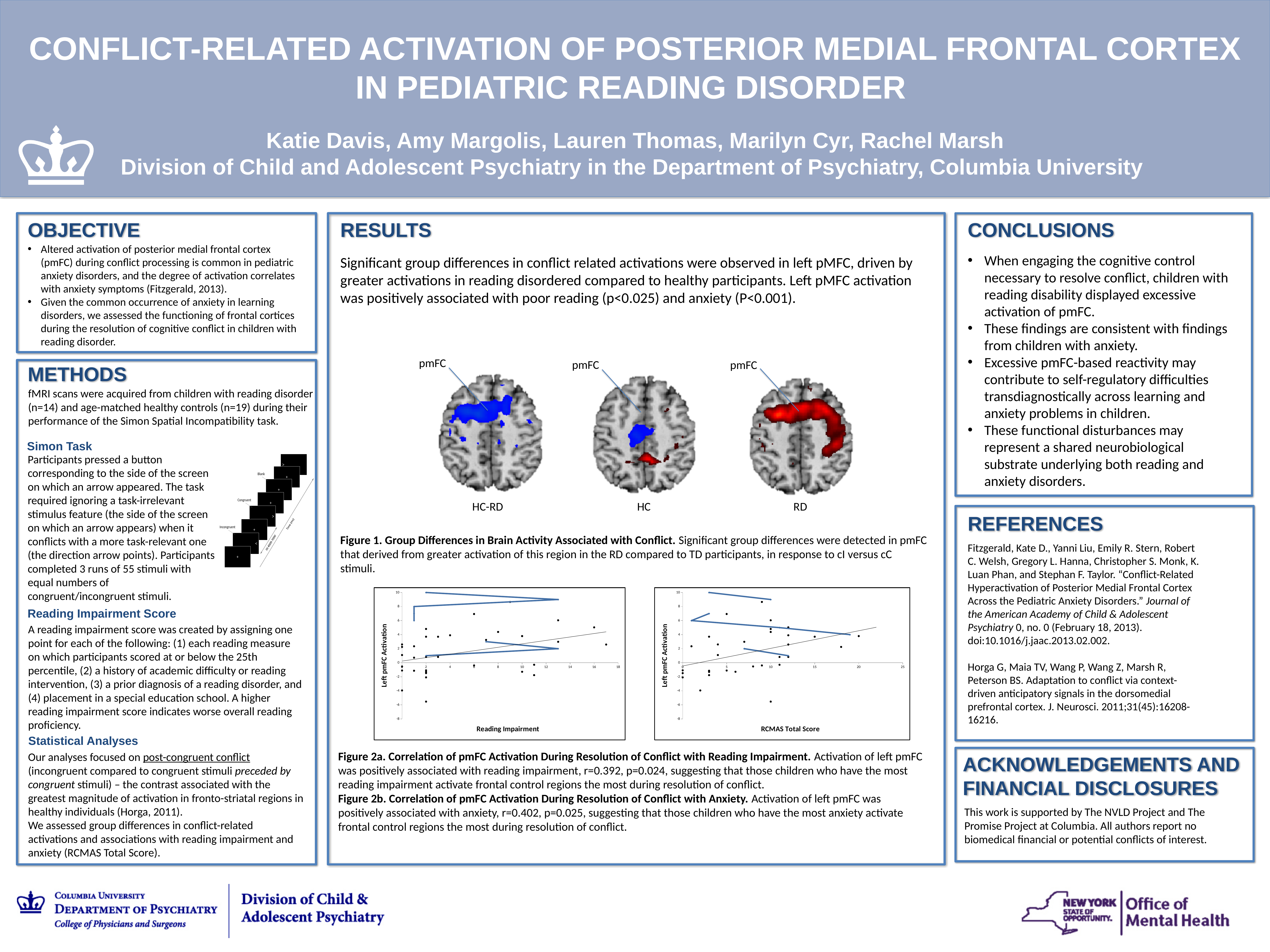
In the left scatter chart (Figure 2a), what is the highest tick value shown on the x axis? 18 What is the y-axis title shared by both scatter charts in Figures 2a and 2b? Left pmFC Activation What is the x-axis title of the left scatter chart (Figure 2a)? Reading Impairment In the right scatter chart (Figure 2b), does the fitted trend line rise or fall as RCMAS Total Score increases? rise In the right scatter chart (Figure 2b), what is the highest tick value shown on the y axis? 10 In the left scatter chart (Figure 2a), what is the lowest tick value shown on the y axis? -8 What kind of chart is Figure 2a, the chart with Reading Impairment on the x axis? scatter chart In the right scatter chart (Figure 2b), what is the highest tick value shown on the x axis? 25 In the left scatter chart (Figure 2a), does the fitted trend line rise or fall as Reading Impairment increases? rise What kind of chart is Figure 2b, the chart with RCMAS Total Score on the x axis? scatter chart